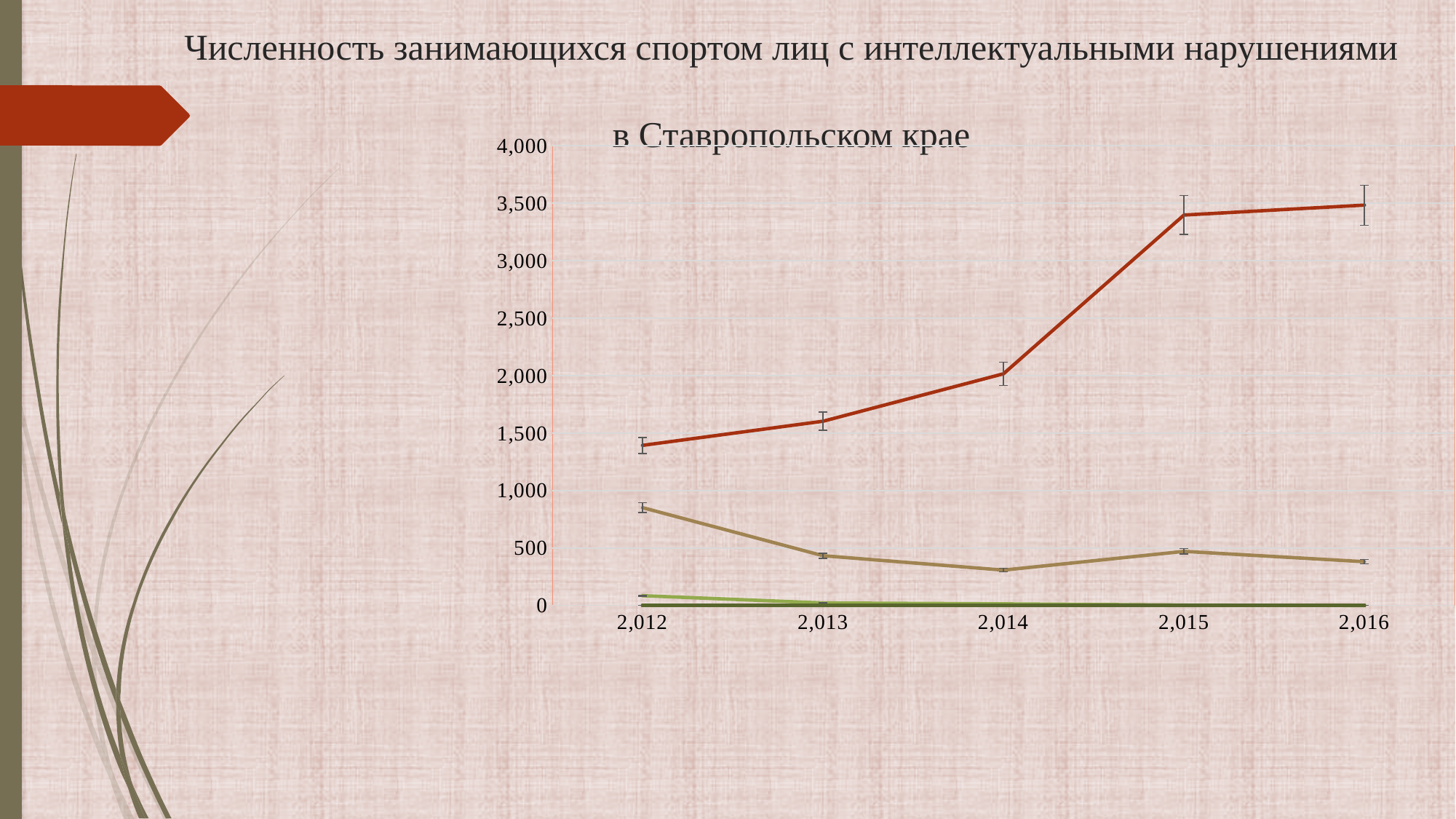
Is the value of the red line in 2,012 greater or less than 1,500? less What is the highest value shown on the y axis? 4,000 In 2,016, which line has the larger value, the red line or the tan line? the red line How many years are shown along the x axis of the chart? 5 What is the first year shown on the x axis? 2,012 In which year does the red line reach its highest value? 2,016 Is the value of the red line in 2,015 greater or less than 3,000? greater In which year does the red line have its lowest value? 2,012 Is the value of the tan line in 2,012 greater or less than 500? greater Does the red line rise or fall from 2,012 to 2,016? rise What kind of chart is shown on the slide? line chart